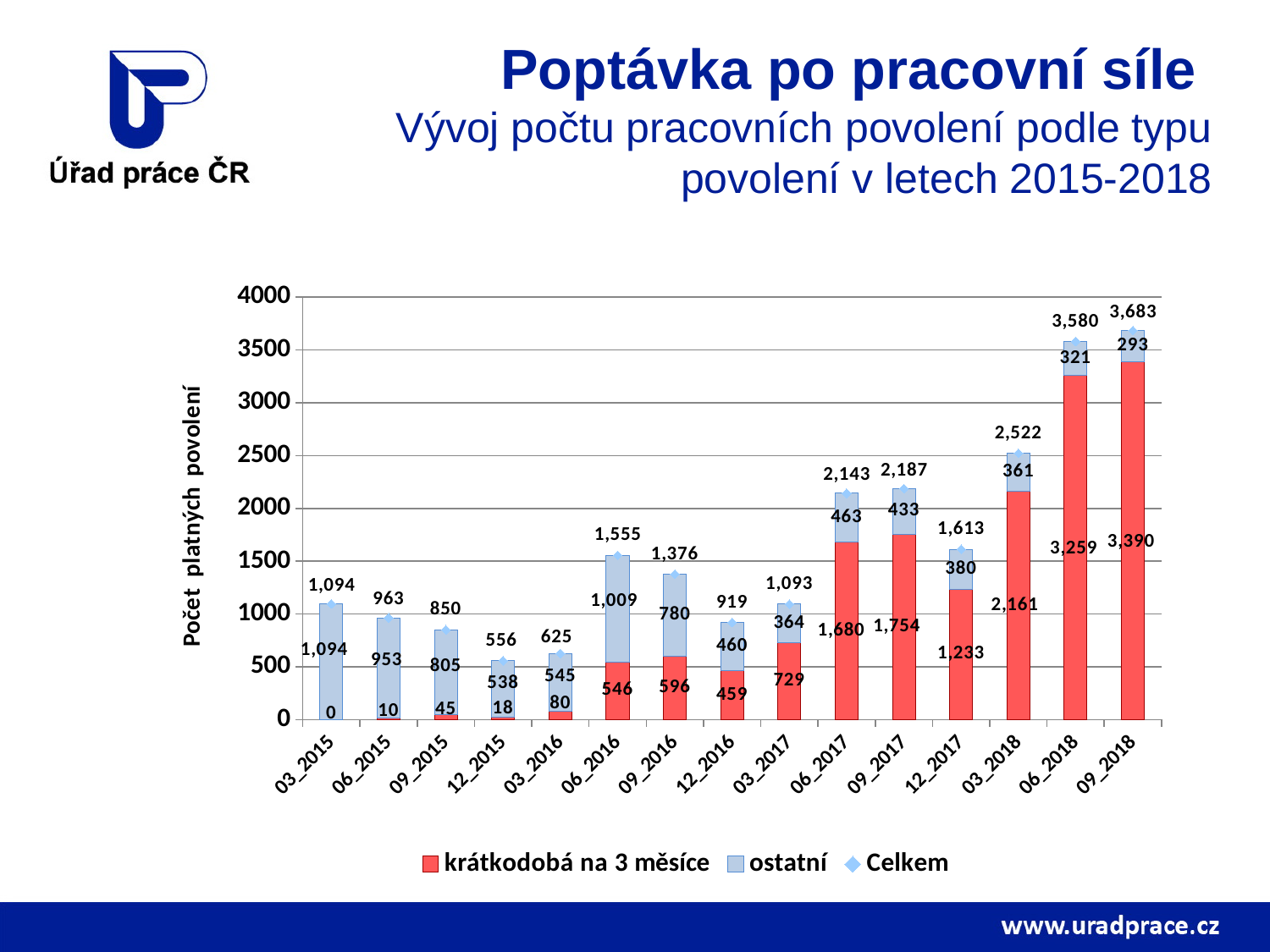
What is the 'Celkem' value for 12_2017? 1,613 What is the value of 'ostatní' for 06_2016? 1,009 What is the value of 'krátkodobá na 3 měsíce' for 09_2018? 3,390 What is the total of the stacked bar for 12_2016? 919 Which period has the highest 'Celkem' value? 09_2018 What is the difference between the 'Celkem' values for 09_2018 and 06_2018? 103 How many series does the legend list? 3 What kind of chart is shown on the slide? Stacked bar chart Which period has the lowest 'krátkodobá na 3 měsíce' value? 03_2015 Is the 'Celkem' value for 03_2018 greater or less than 2500? greater Which is larger: the 'ostatní' value for 06_2017 or for 09_2017? 06_2017 How many periods are shown on the x axis? 15